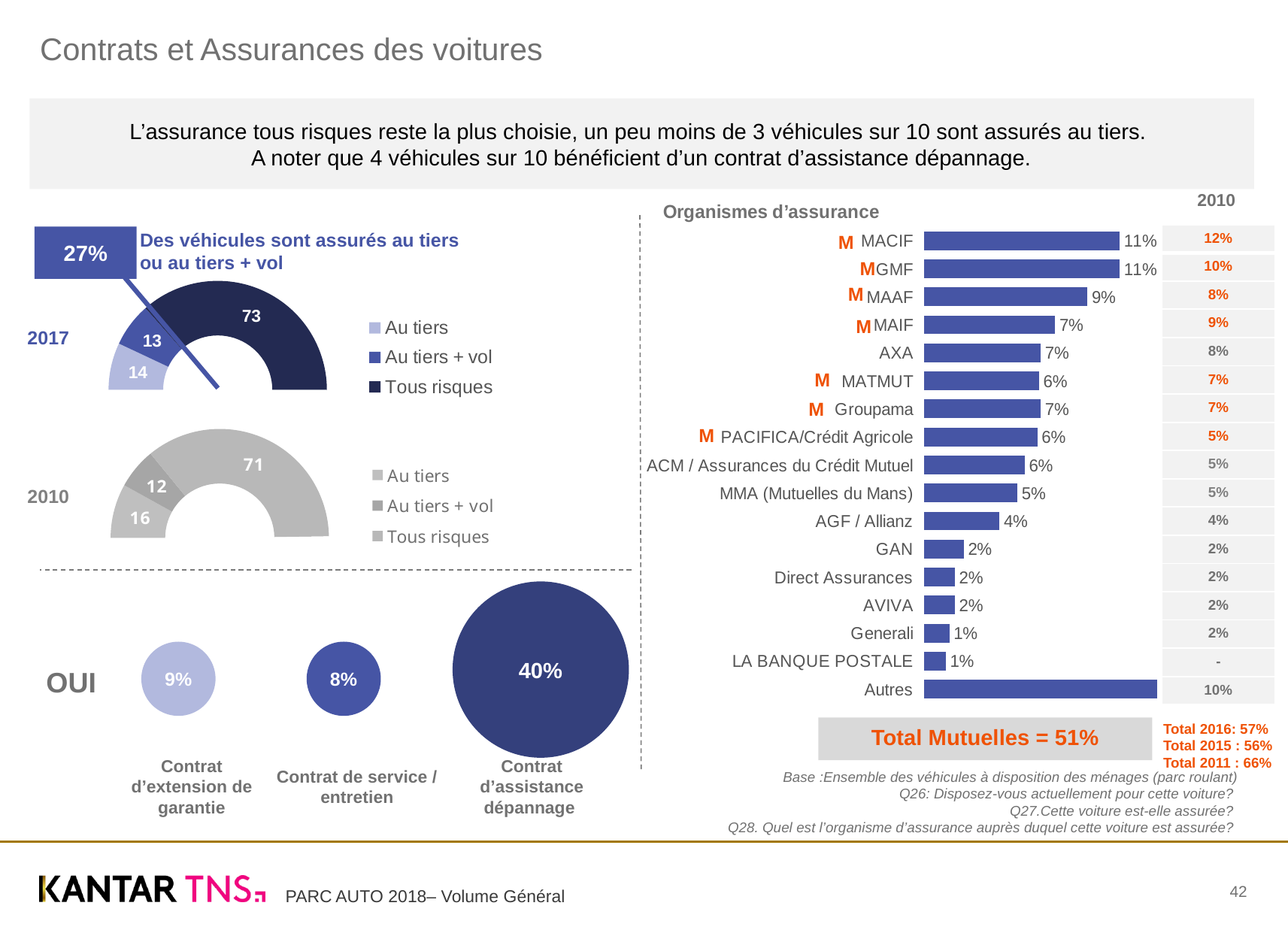
What kind of chart is the 'Organismes d'assurance' chart? Bar chart How many legend entries does the 2017 half-donut chart on the left list? 3 In the 'Organismes d'assurance' bar chart, what is the value for AGF / Allianz? 4% In the 2017 half-donut chart on the left, which category has the lowest value? Au tiers + vol In the 'Organismes d'assurance' bar chart, which is larger, the value for MAAF or the value for AXA? MAAF In the 2017 half-donut chart on the left, what is the value for 'Tous risques'? 73 In the bubble chart at the bottom left, what is the value for 'Contrat d'assistance dépannage'? 40% In the 'Organismes d'assurance' bar chart, what is the value for Generali? 1% In the 2010 half-donut chart on the left, what is the value for 'Au tiers'? 16 In the 'Organismes d'assurance' bar chart, what is the 2010 value shown for MAIF? 9% In the 'Organismes d'assurance' bar chart, what is the value for MAAF? 9% In the 'Organismes d'assurance' bar chart, what is the difference between the values for MACIF and MAIF? 4%